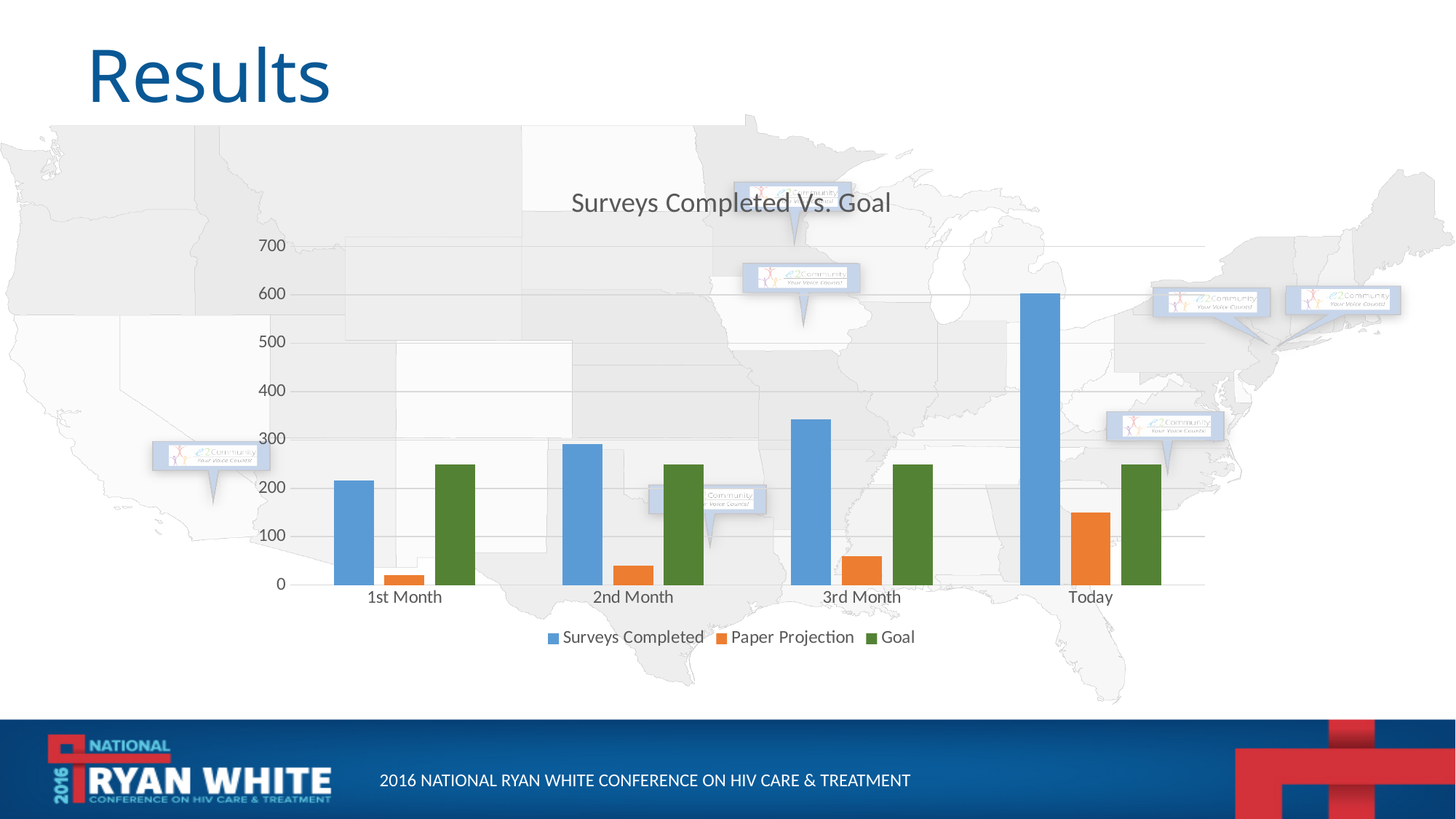
What is the title of the chart? Surveys Completed Vs. Goal In which category is the Paper Projection value lowest? 1st Month In 1st Month, which is larger: Surveys Completed or Goal? Goal How many categories are shown on the x axis? 4 What kind of chart is shown on the slide? Bar chart Do the Surveys Completed values rise or fall from 1st Month to Today? rise Is the Surveys Completed value for Today greater or less than 500? greater Is the Paper Projection value for Today greater or less than 200? less In which category is the Surveys Completed value highest? Today How many series does the legend list? 3 In 2nd Month, which is larger: Surveys Completed or Goal? Surveys Completed Is the Surveys Completed value for 3rd Month greater or less than 300? greater